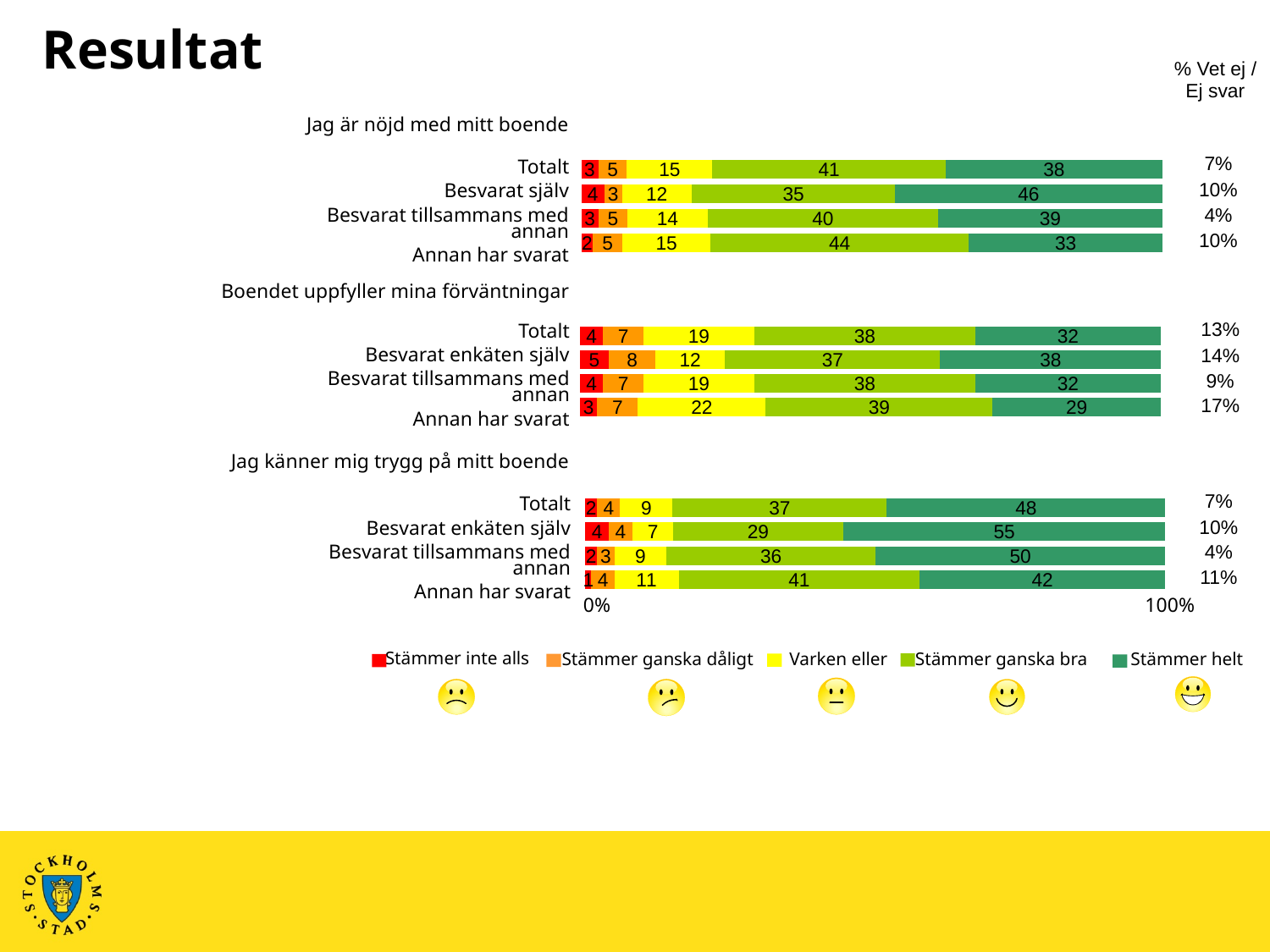
How many series does the legend list? 5 What kind of chart is used on the slide? Stacked bar chart How many rows (bars) are shown in the chart 'Jag känner mig trygg på mitt boende'? 4 Which legend entry is shown in dark green? Stämmer helt In the chart 'Jag känner mig trygg på mitt boende', what is the value of 'Stämmer ganska bra' for 'Totalt'? 37 In the chart 'Jag är nöjd med mitt boende', which row has the lowest 'Stämmer helt' value? Annan har svarat In the chart 'Jag känner mig trygg på mitt boende', which row has the highest 'Stämmer helt' value? Besvarat enkäten själv In the chart 'Jag är nöjd med mitt boende', what is the value of 'Stämmer helt' for 'Besvarat själv'? 46 In the chart 'Boendet uppfyller mina förväntningar', what is the 'Varken eller' value for 'Annan har svarat'? 22 In the chart 'Boendet uppfyller mina förväntningar', is the 'Stämmer helt' value larger for 'Besvarat enkäten själv' or for 'Annan har svarat'? Besvarat enkäten själv What is the '% Vet ej / Ej svar' value shown for 'Totalt' in the chart 'Boendet uppfyller mina förväntningar'? 13% In the chart 'Jag är nöjd med mitt boende', what is the difference between the 'Stämmer ganska bra' values for 'Annan har svarat' and 'Besvarat själv'? 9